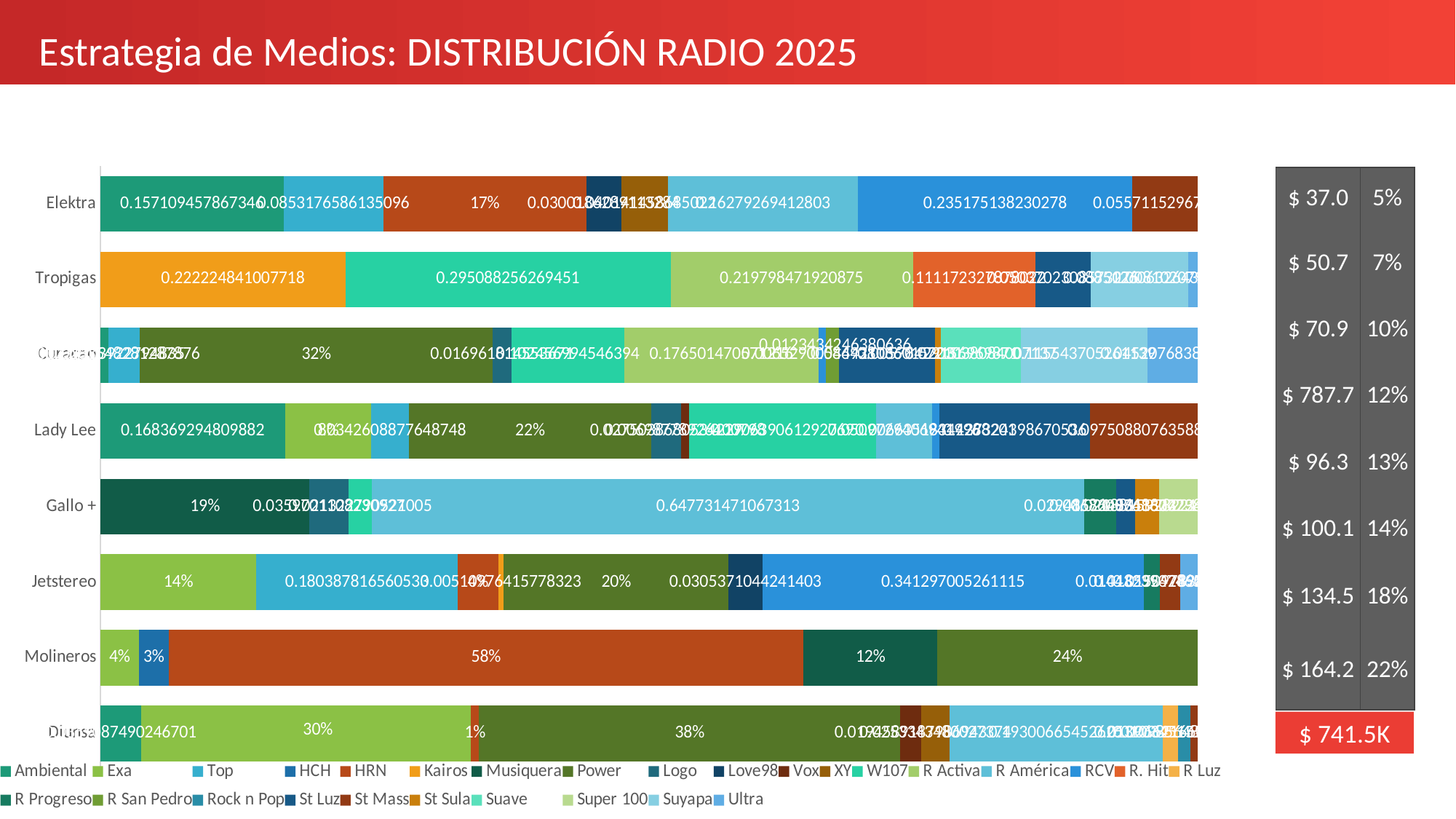
For Molineros, what is the difference between the Power share and the Musiquera share? 12% For Molineros, which is larger: the Power share or the Musiquera share? Power What is the Power share for Molineros? 24% What is the Power share for Diunsa? 38% What is the RCV value for Jetstereo? 0.341297005261115 Which station has the largest share of the Molineros bar? HRN How many series does the legend list? 28 What kind of chart is shown on the slide? Stacked bar chart How many companies (categories) are plotted on the chart? 8 What is the HRN share for Molineros? 58%